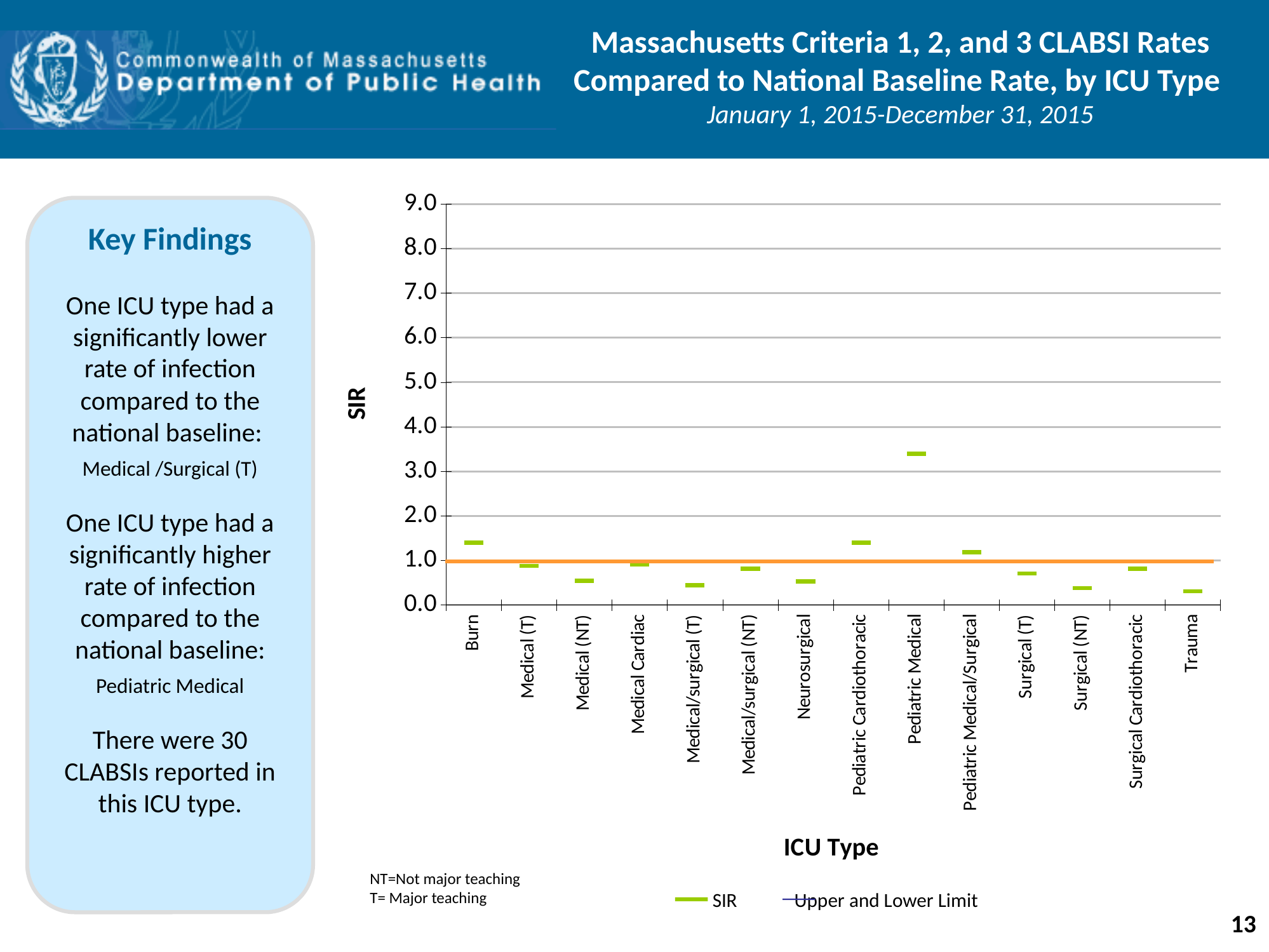
Which has a higher SIR value, Burn or Medical (NT)? Burn Which has a lower SIR value, Surgical (NT) or Pediatric Cardiothoracic? Surgical (NT) What is the label on the vertical axis of the chart? SIR Which ICU type has the highest SIR value in the chart? Pediatric Medical Is the SIR value for Medical (NT) greater or less than 1.0? less Which has a higher SIR value, Pediatric Medical or Burn? Pediatric Medical Is the SIR value for Burn greater or less than 1.0? greater Is the SIR value for Pediatric Medical greater or less than 3.0? greater How many ICU types are shown on the x axis of the chart? 14 How many series does the chart legend list? 2